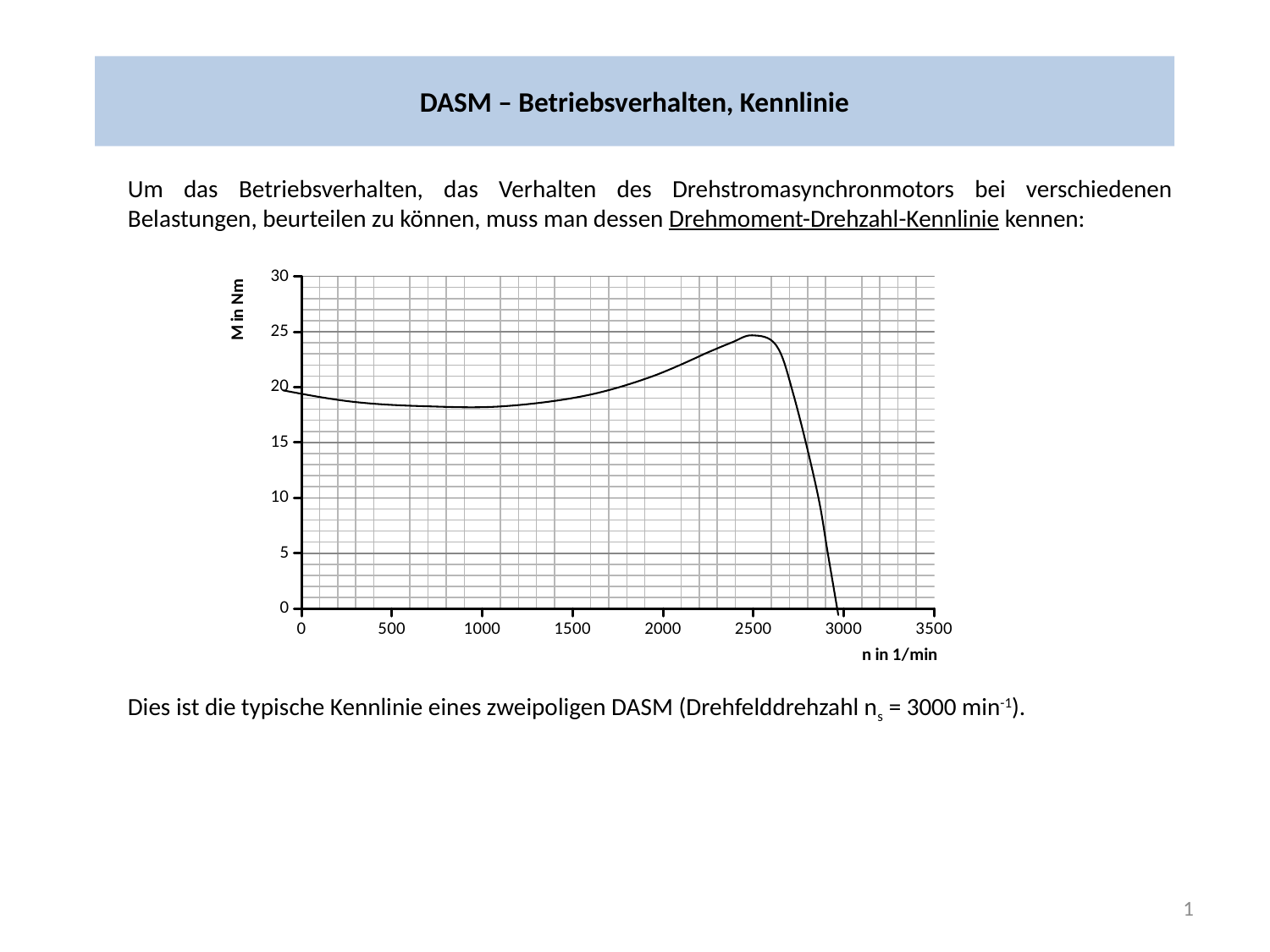
Between n = 2500 and n = 3000, does the curve rise or fall? fall What is the label of the horizontal axis of the chart? n in 1/min Between n = 1000 and n = 2500, does the curve rise or fall? rise What kind of chart is shown on the slide? line chart Is the value of M at n = 0 greater or less than 15? greater Is the value of M at n = 1000 greater or less than 20? less What is the label of the vertical axis of the chart? M in Nm Is the value of M at n = 500 greater or less than 25? less At which labelled x-axis tick does the curve reach its highest value of M? 2500